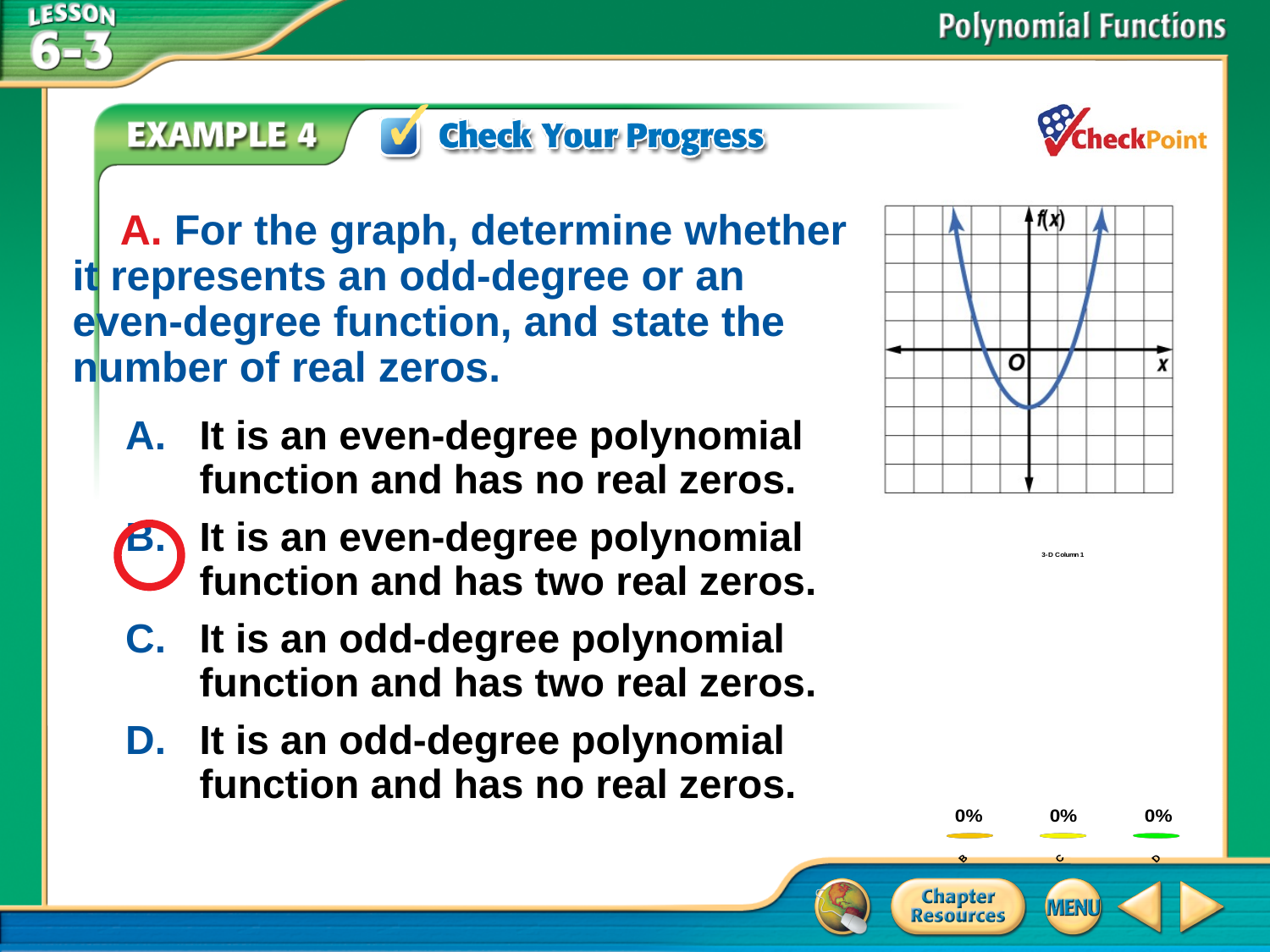
What kind of chart is shown at the bottom right of the slide? bar chart In the chart at the bottom right, do the bar values rise, fall, or stay the same from left to right? stay the same What is the sum of the three values labelled on the chart at the bottom right? 0% How many bars does the chart at the bottom right of the slide show? 3 What value is labelled on the leftmost bar of the chart at the bottom right? 0% What value is labelled on the middle bar of the chart at the bottom right? 0% In the chart at the bottom right, what is the difference between the leftmost and rightmost bar values? 0% What value is labelled on the rightmost bar of the chart at the bottom right? 0%